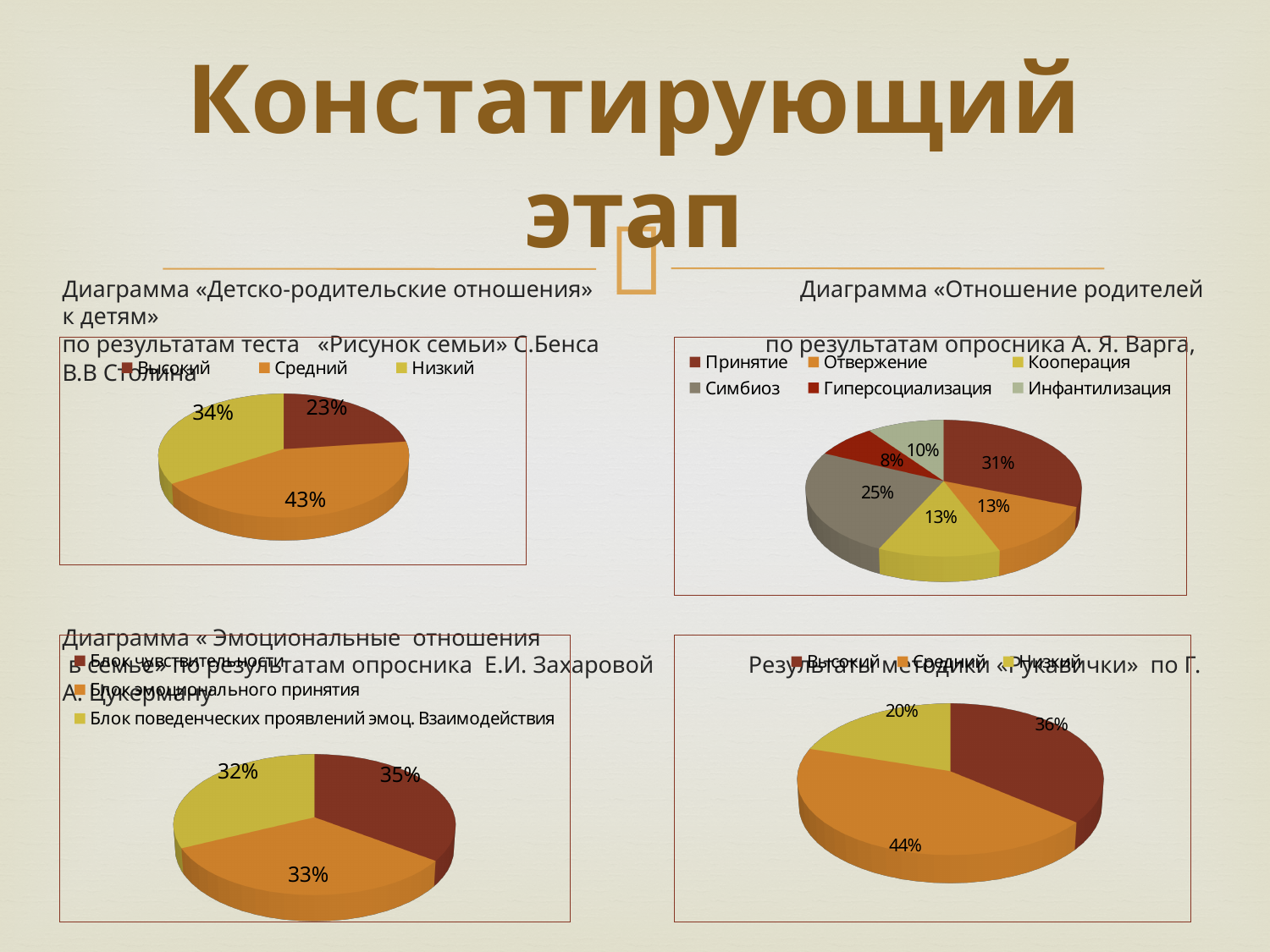
In the top-left pie chart (Детско-родительские отношения), what percentage is shown for Средний? 43% What type of chart is used for the bottom-right chart (Рукавички)? Pie chart In the top-left pie chart (Детско-родительские отношения), which category has the smallest share? Высокий In the bottom-right pie chart (Рукавички), what percentage is shown for Низкий? 20% In the top-right pie chart (Отношение родителей к детям), which category has the smallest share? Гиперсоциализация In the top-right pie chart (Отношение родителей к детям), which category has the largest share? Принятие How many categories does the legend of the top-right pie chart (Отношение родителей к детям) list? 6 In the top-right pie chart (Отношение родителей к детям), what percentage is shown for Симбиоз? 25% In the bottom-right pie chart (Рукавички), which category has the largest share? Средний In the bottom-left pie chart (Эмоциональные отношения в семье), which is larger: Блок эмоционального принятия or Блок поведенческих проявлений эмоц. взаимодействия? Блок эмоционального принятия In the top-left pie chart (Детско-родительские отношения), what is the difference between the Средний and Высокий shares? 20% In the bottom-left pie chart (Эмоциональные отношения в семье), what percentage is shown for Блок чувствительности? 35%